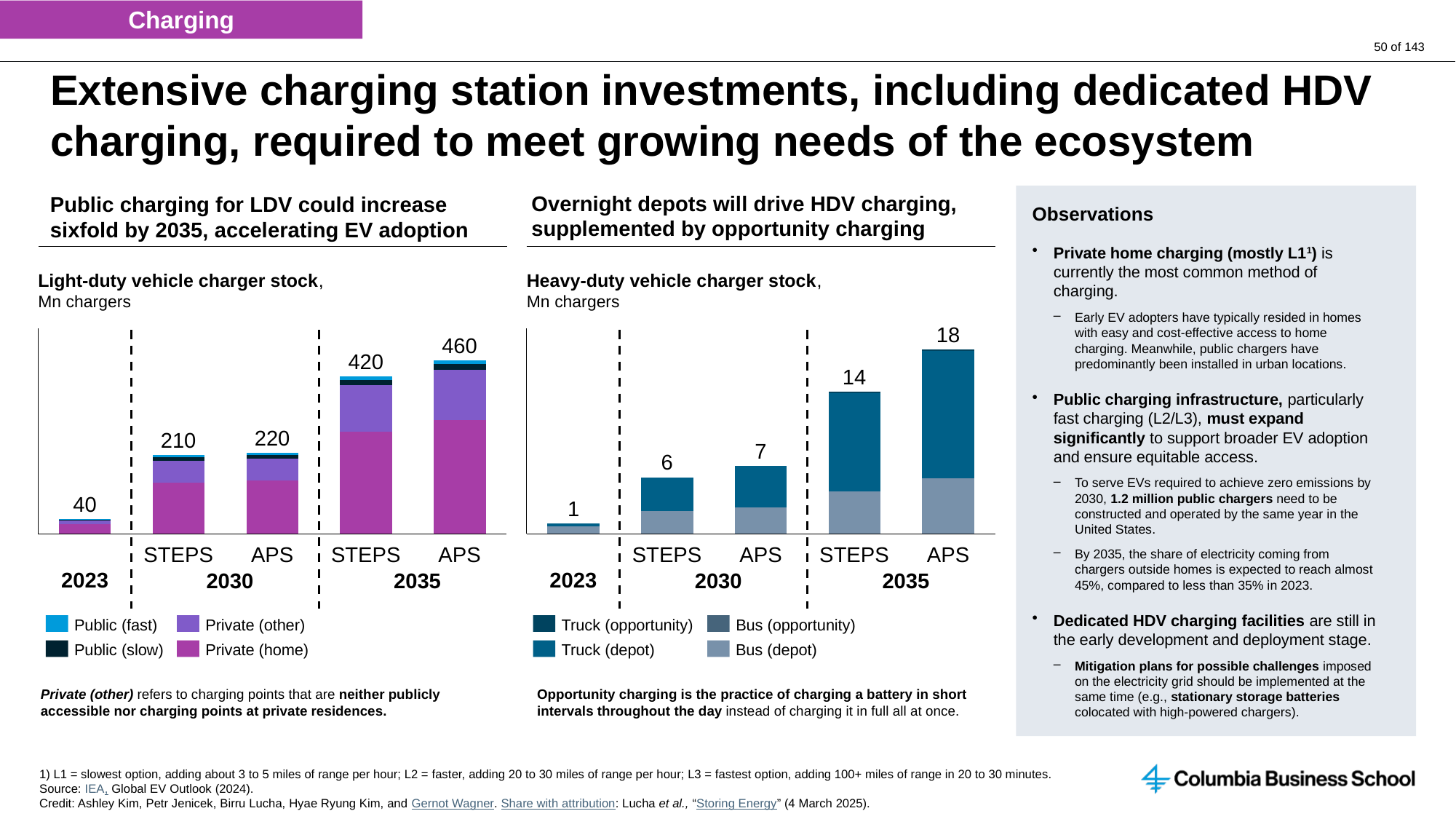
In the Light-duty vehicle charger stock chart, what is the total charger stock labelled for 2035 APS? 460 In the Heavy-duty vehicle charger stock chart, which bar has the lowest total? 2023 In the Light-duty vehicle charger stock chart, what is the total charger stock labelled for 2023? 40 In the Light-duty vehicle charger stock chart, which bar has the highest total? 2035 APS In the Heavy-duty vehicle charger stock chart, what is the difference between the 2035 APS total and the 2035 STEPS total? 4 In the Light-duty vehicle charger stock chart, which is larger: the 2030 STEPS total or the 2030 APS total? 2030 APS In the Heavy-duty vehicle charger stock chart, what is the total charger stock labelled for 2030 APS? 7 In the Light-duty vehicle charger stock chart, what is the difference between the 2035 STEPS total and the 2030 STEPS total? 210 How many series does the legend of the Light-duty vehicle charger stock chart list? 4 How many bars are shown in the Heavy-duty vehicle charger stock chart? 5 In the Heavy-duty vehicle charger stock chart, what is the total charger stock labelled for 2035 STEPS? 14 What kind of chart is the Heavy-duty vehicle charger stock chart? Stacked bar chart